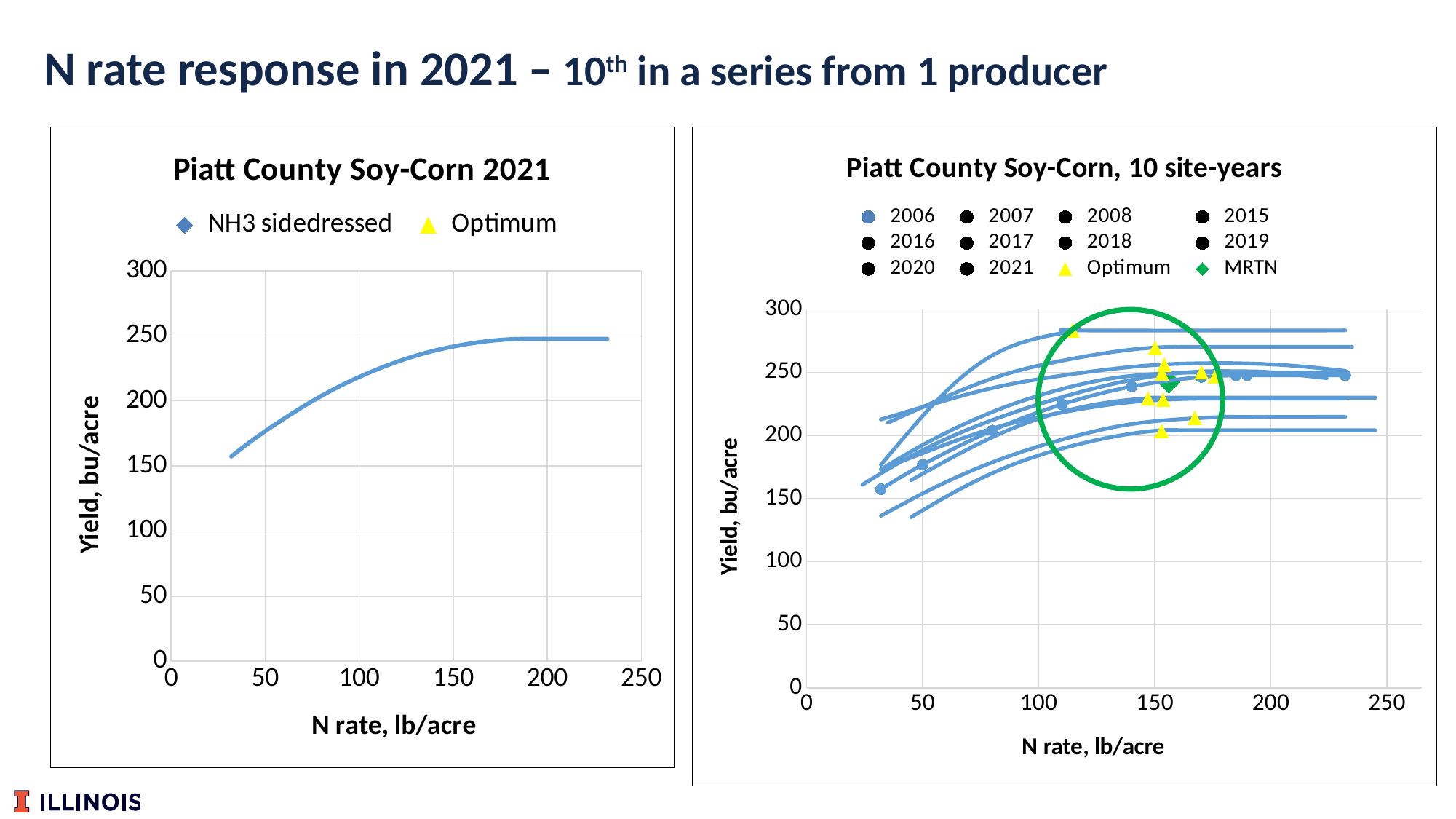
What is the title of the chart on the right? Piatt County Soy-Corn, 10 site-years In the Piatt County Soy-Corn 2021 chart, does yield rise or fall as N rate increases? rise In the Piatt County Soy-Corn 2021 chart, is the yield at an N rate of 150 lb/acre greater or less than 200? greater In the Piatt County Soy-Corn 2021 chart, is the yield at an N rate of 100 lb/acre greater or less than 200? greater In the Piatt County Soy-Corn 2021 chart, is the yield at an N rate of 50 lb/acre greater or less than 200? less In the Piatt County Soy-Corn 2021 chart, how many series does the legend list? 2 What is the y-axis label of the Piatt County Soy-Corn 2021 chart? Yield, bu/acre In the Piatt County Soy-Corn, 10 site-years chart, how many entries does the legend list? 12 What is the title of the chart on the left? Piatt County Soy-Corn 2021 In the Piatt County Soy-Corn, 10 site-years chart, how many different years are listed in the legend? 10 What kind of chart is the Piatt County Soy-Corn 2021 chart? line chart